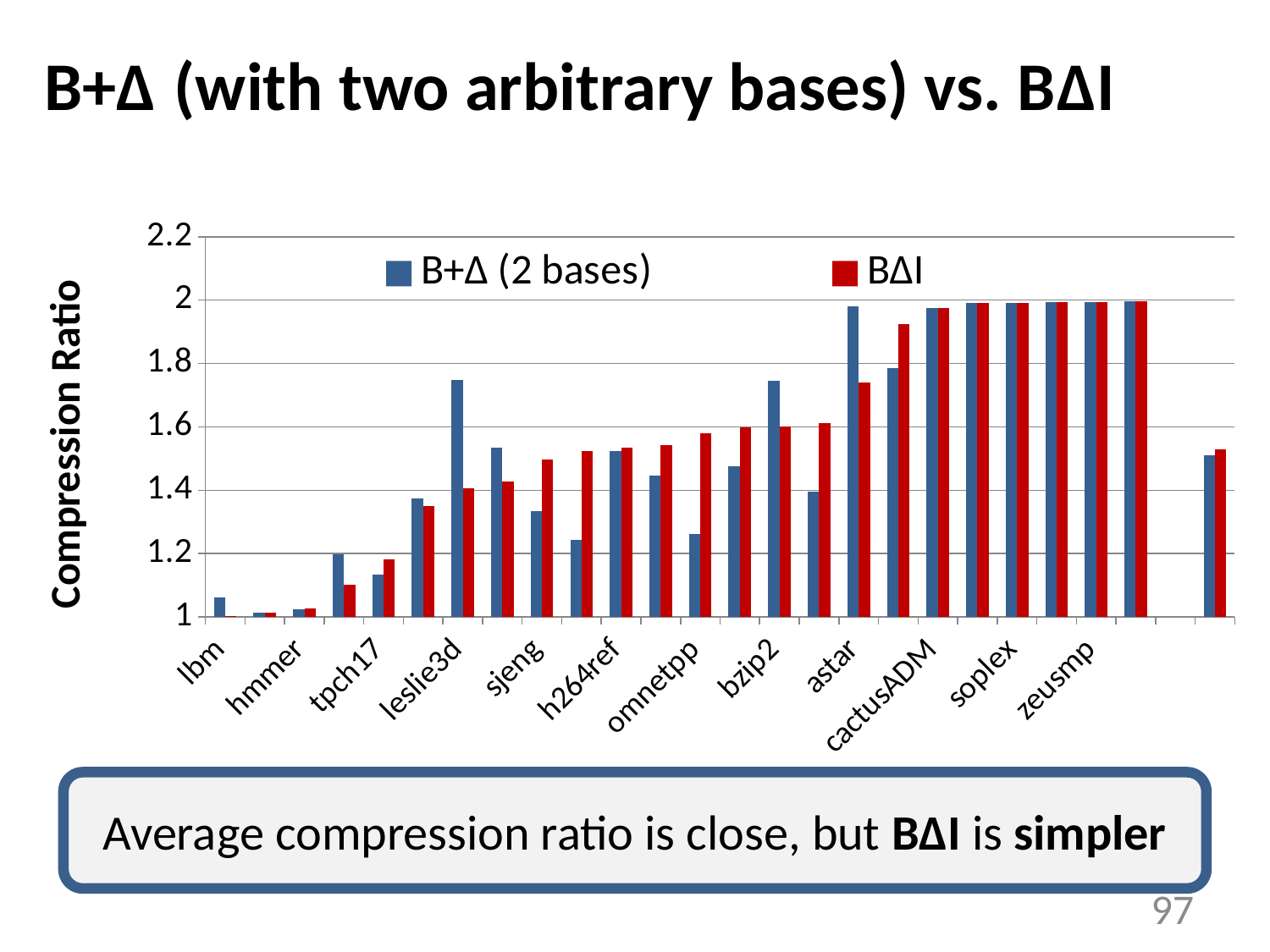
What is the label of the vertical axis? Compression Ratio What are the two series named in the legend? B+Δ (2 bases) and BΔI For astar, which series has the larger compression ratio, B+Δ (2 bases) or BΔI? B+Δ (2 bases) For leslie3d, which series has the larger compression ratio, B+Δ (2 bases) or BΔI? B+Δ (2 bases) Is the B+Δ (2 bases) value for leslie3d greater or less than 1.6? greater Is the BΔI value for astar greater or less than 1.8? less Do the BΔI values generally rise or fall from left to right across the benchmarks? rise How many series does the legend list? 2 Is the B+Δ (2 bases) value for omnetpp greater or less than 1.4? less What kind of chart is shown on the slide? bar chart For omnetpp, which series has the larger compression ratio, B+Δ (2 bases) or BΔI? BΔI